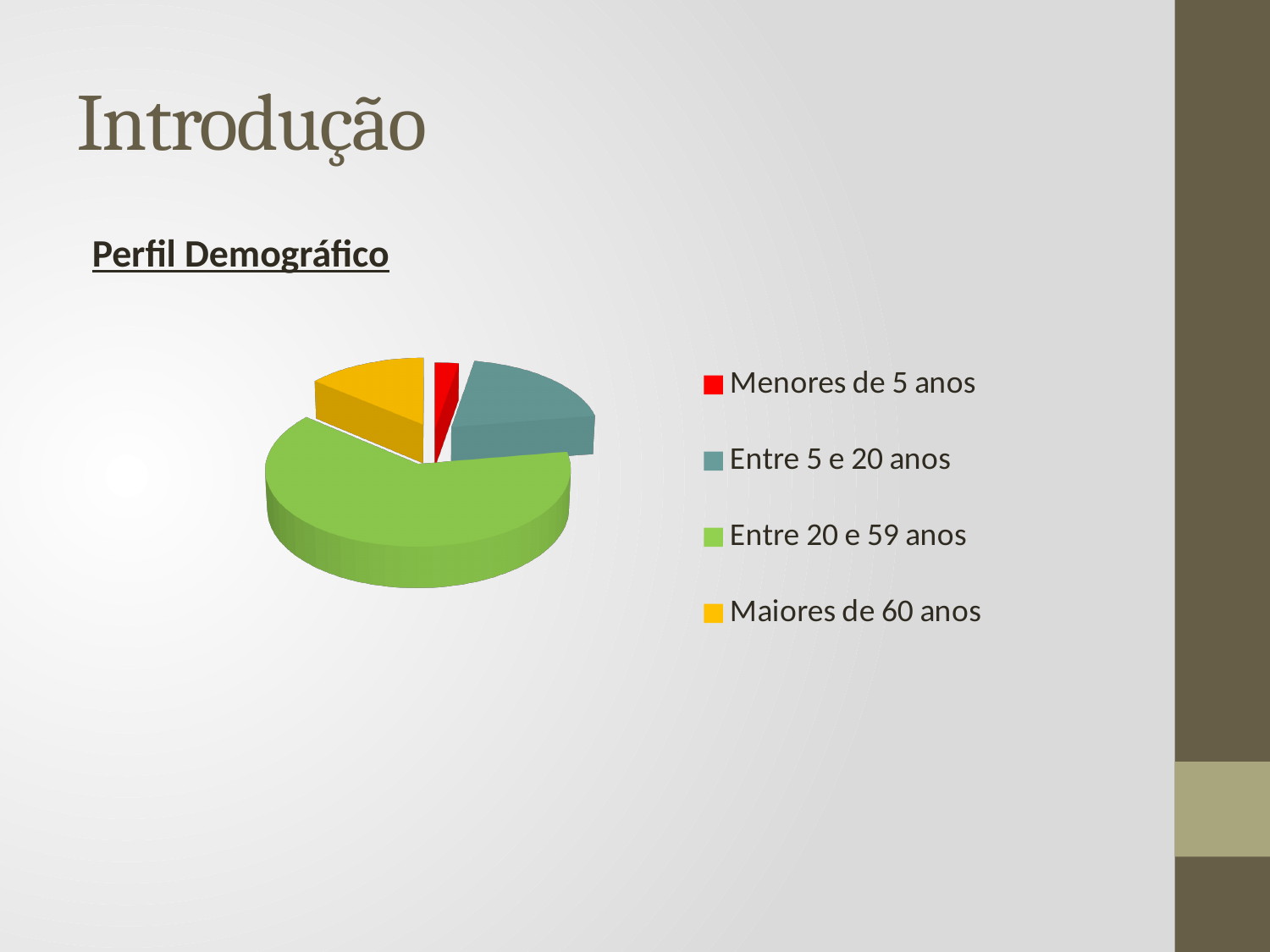
What kind of chart is shown on the slide? Pie chart Which slice is larger in the pie chart: Maiores de 60 anos or Menores de 5 anos? Maiores de 60 anos Which category has the smallest slice in the pie chart? Menores de 5 anos How many entries does the legend of the pie chart list? 4 Which category is shown in green in the pie chart? Entre 20 e 59 anos Which colour represents Menores de 5 anos in the pie chart? Red Which slice is larger in the pie chart: Entre 20 e 59 anos or Maiores de 60 anos? Entre 20 e 59 anos Which slice is larger in the pie chart: Entre 20 e 59 anos or Entre 5 e 20 anos? Entre 20 e 59 anos Which category has the largest slice in the pie chart? Entre 20 e 59 anos How many slices does the pie chart have? 4